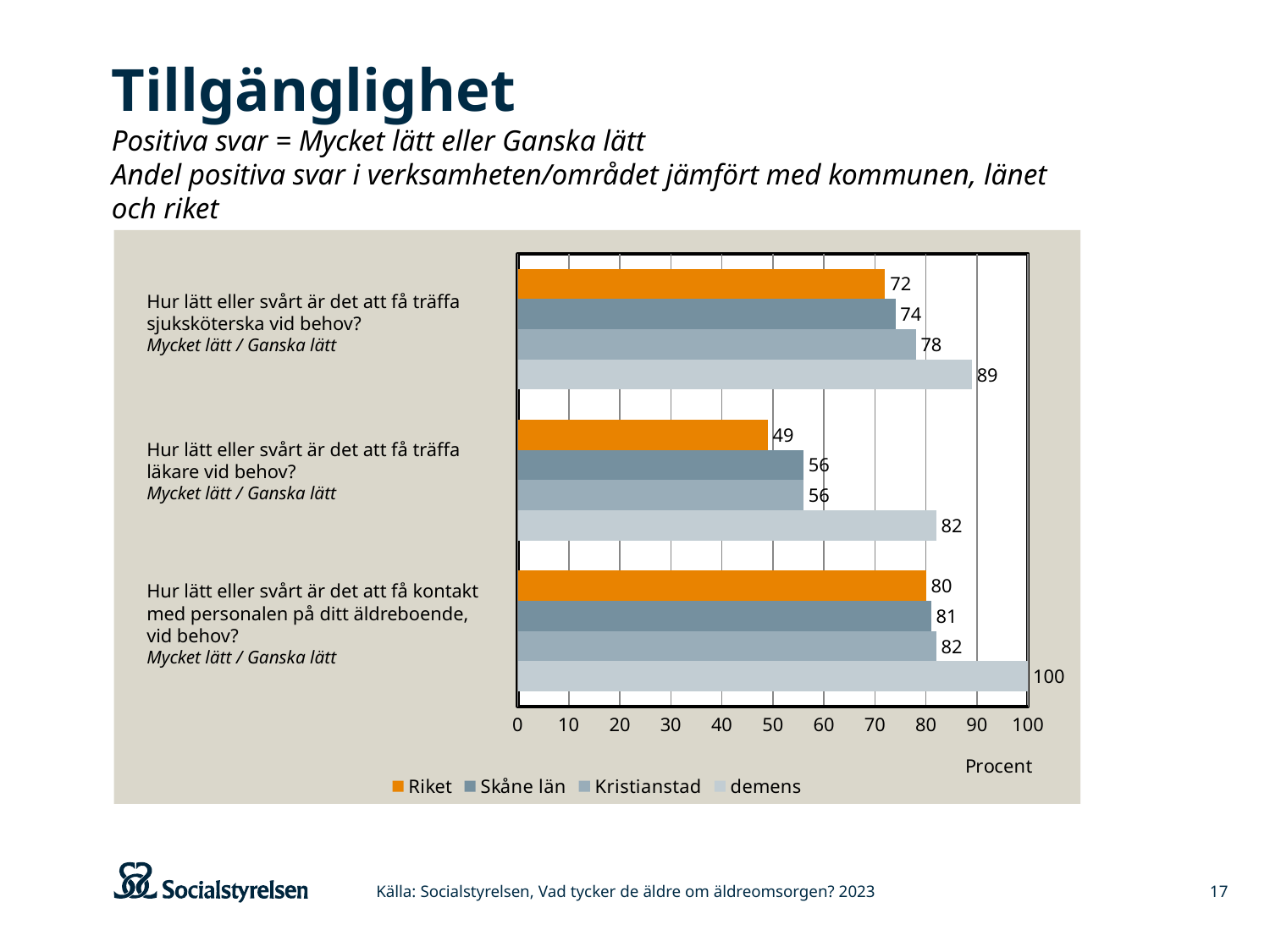
What is the value for demens for the question about how easy or hard it is to meet a doctor (läkare) when needed? 82 Which series has the lowest value for the question about how easy or hard it is to meet a doctor (läkare) when needed? Riket What is the difference between the demens value and the Riket value for the question about meeting a nurse (sjuksköterska) when needed? 17 How many question categories are shown on the chart? 3 Which series has the highest value for the question about getting in contact with staff at the care home when needed? demens What is the value for Skåne län for the question about how easy or hard it is to meet a doctor (läkare) when needed? 56 What is the value for Riket for the question about how easy or hard it is to meet a nurse (sjuksköterska) when needed? 72 Which is larger for the question about meeting a doctor (läkare) when needed: the value for demens or the value for Riket? demens What kind of chart is shown on the slide? Bar chart What unit label is shown below the x axis of the chart? Procent What is the value for Kristianstad for the question about getting in contact with staff at the care home (kontakt med personalen) when needed? 82 How many series does the legend list? 4